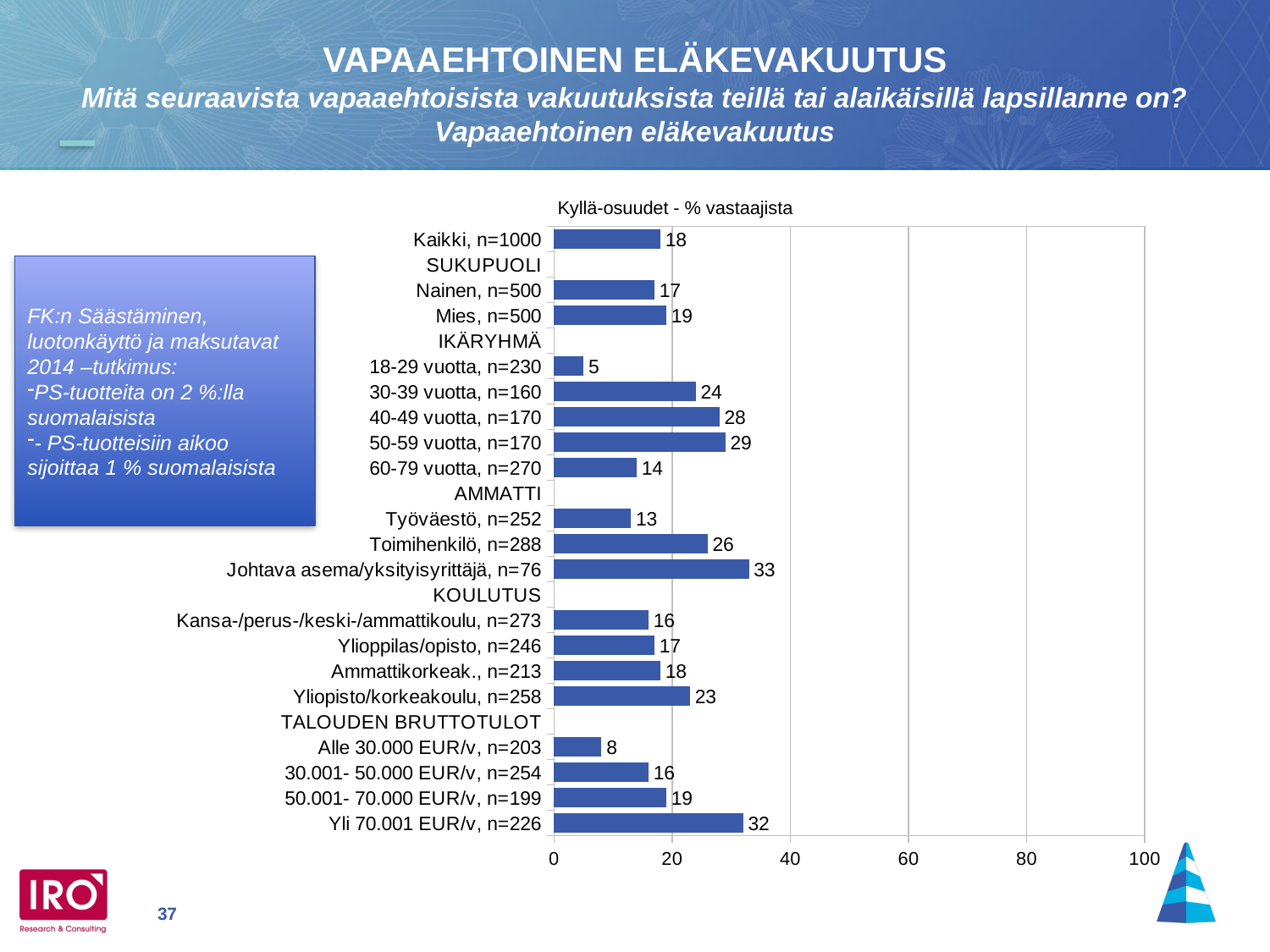
What is the difference between the values for Yli 70.001 EUR/v, n=226 and Alle 30.000 EUR/v, n=203? 24 Which category has the lowest value? 18-29 vuotta, n=230 What is the value for Johtava asema/yksityisyrittäjä, n=76? 33 What is the value for Kaikki, n=1000? 18 What is the difference between the values for Mies, n=500 and Nainen, n=500? 2 Which is larger, the value for Toimihenkilö, n=288 or Työväestö, n=252? Toimihenkilö, n=288 What kind of chart is shown on the slide? bar chart Is the value for 50-59 vuotta, n=170 greater or less than 20? greater What is the title of the chart? Kyllä-osuudet - % vastaajista What is the value for 18-29 vuotta, n=230? 5 Which category has the highest value? Johtava asema/yksityisyrittäjä, n=76 What is the value for Yli 70.001 EUR/v, n=226? 32